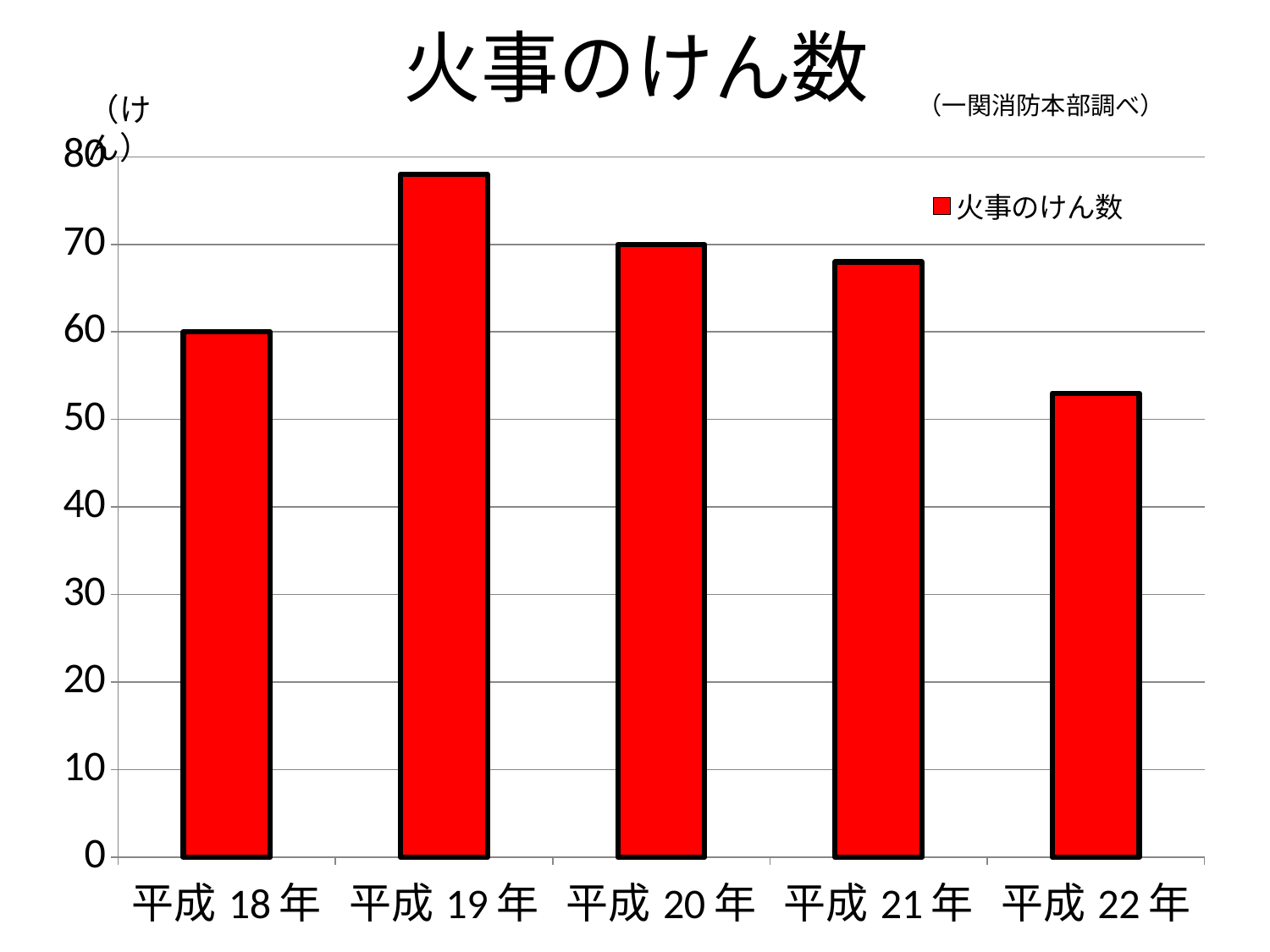
Is the value for 平成22年 greater or less than 60? less What is the title of the chart? 火事のけん数 How many categories (years) are shown on the x axis? 5 What kind of chart is shown on the slide? bar chart Is the value for 平成19年 greater or less than 70? greater How many series does the legend list? 1 What is the value for 平成20年? 70 Which year has the highest number of fires? 平成19年 Which year has the lowest number of fires? 平成22年 Which is larger, the value for 平成19年 or the value for 平成22年? 平成19年 What is the value for 平成18年? 60 From 平成19年 to 平成22年, do the values rise or fall? fall